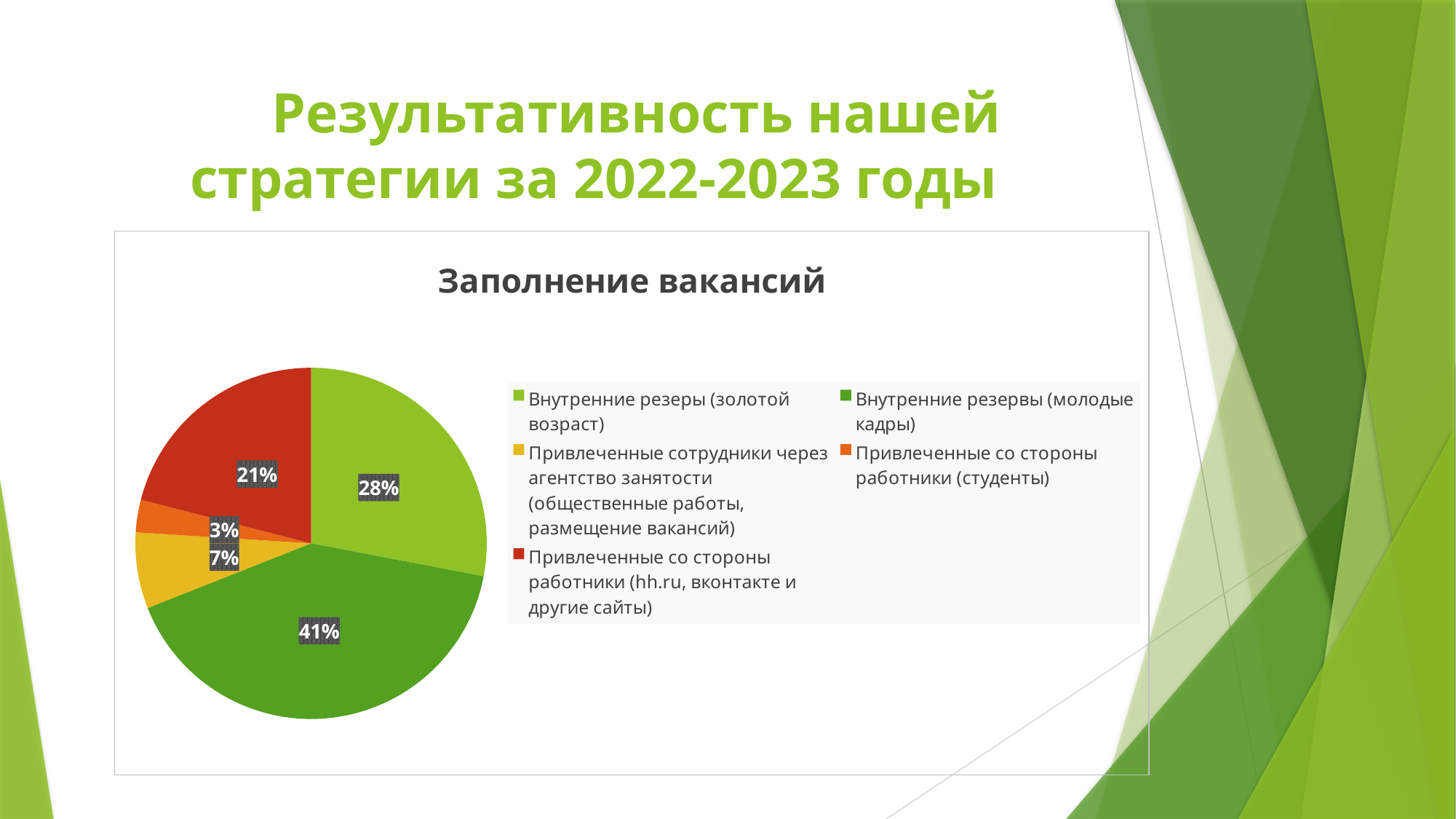
Which category has the largest slice of the pie? Внутренние резервы (молодые кадры) What share of the pie is labelled for Внутренние резервы (золотой возраст)? 28% What share of the pie is labelled for Привлеченные со стороны работники (студенты)? 3% What share of the pie is labelled for Внутренние резервы (молодые кадры)? 41% What is the difference in percentage points between the slices for Внутренние резервы (молодые кадры) and Внутренние резервы (золотой возраст)? 13 What share of the pie is labelled for Привлеченные со стороны работники (hh.ru, вконтакте и другие сайты)? 21% Which is larger: the slice for Привлеченные со стороны работники (hh.ru, вконтакте и другие сайты) or the slice for Привлеченные сотрудники через агентство занятости? Привлеченные со стороны работники (hh.ru, вконтакте и другие сайты) What is the title of the chart? Заполнение вакансий What type of chart is shown on the slide? Pie chart Which category has the smallest slice of the pie? Привлеченные со стороны работники (студенты) How many slices does the pie chart have? 5 What share of the pie is labelled for Привлеченные сотрудники через агентство занятости (общественные работы, размещение вакансий)? 7%